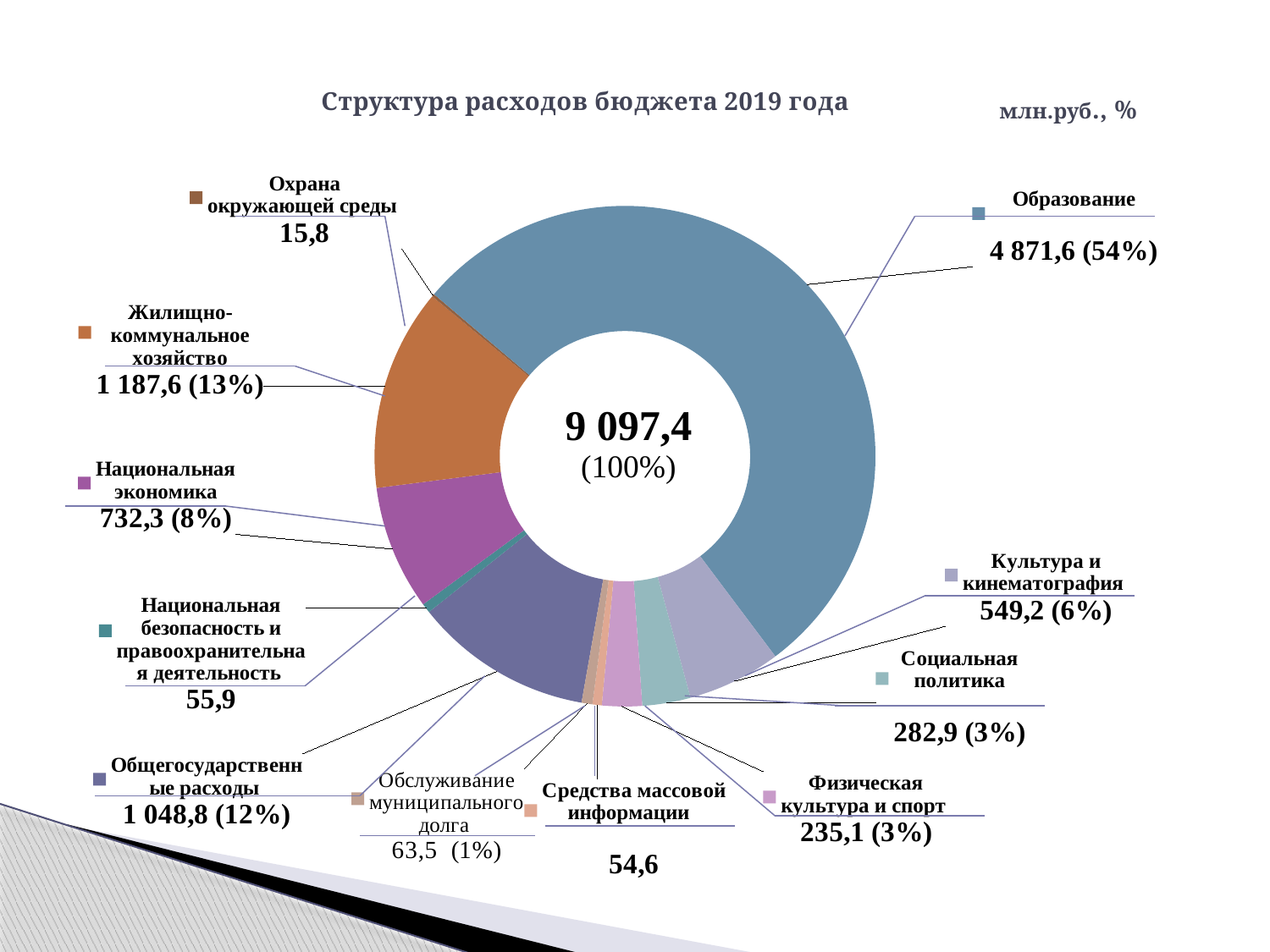
Which category has the smallest value in the chart? Охрана окружающей среды Which category has the largest share of the budget expenditure? Образование What is the difference between Образование and Жилищно-коммунальное хозяйство? 3 684,0 Which is larger, Общегосударственные расходы or Национальная экономика? Общегосударственные расходы What is the value for Жилищно-коммунальное хозяйство? 1 187,6 What is the value for Образование in the chart? 4 871,6 What is the difference between Социальная политика and Физическая культура и спорт? 47,8 How many expenditure categories are shown in the chart? 11 What share of the total does Культура и кинематография account for? 6% What is the value for Средства массовой информации? 54,6 What is the total budget expenditure shown in the centre of the chart? 9 097,4 What kind of chart is shown on the slide? doughnut chart